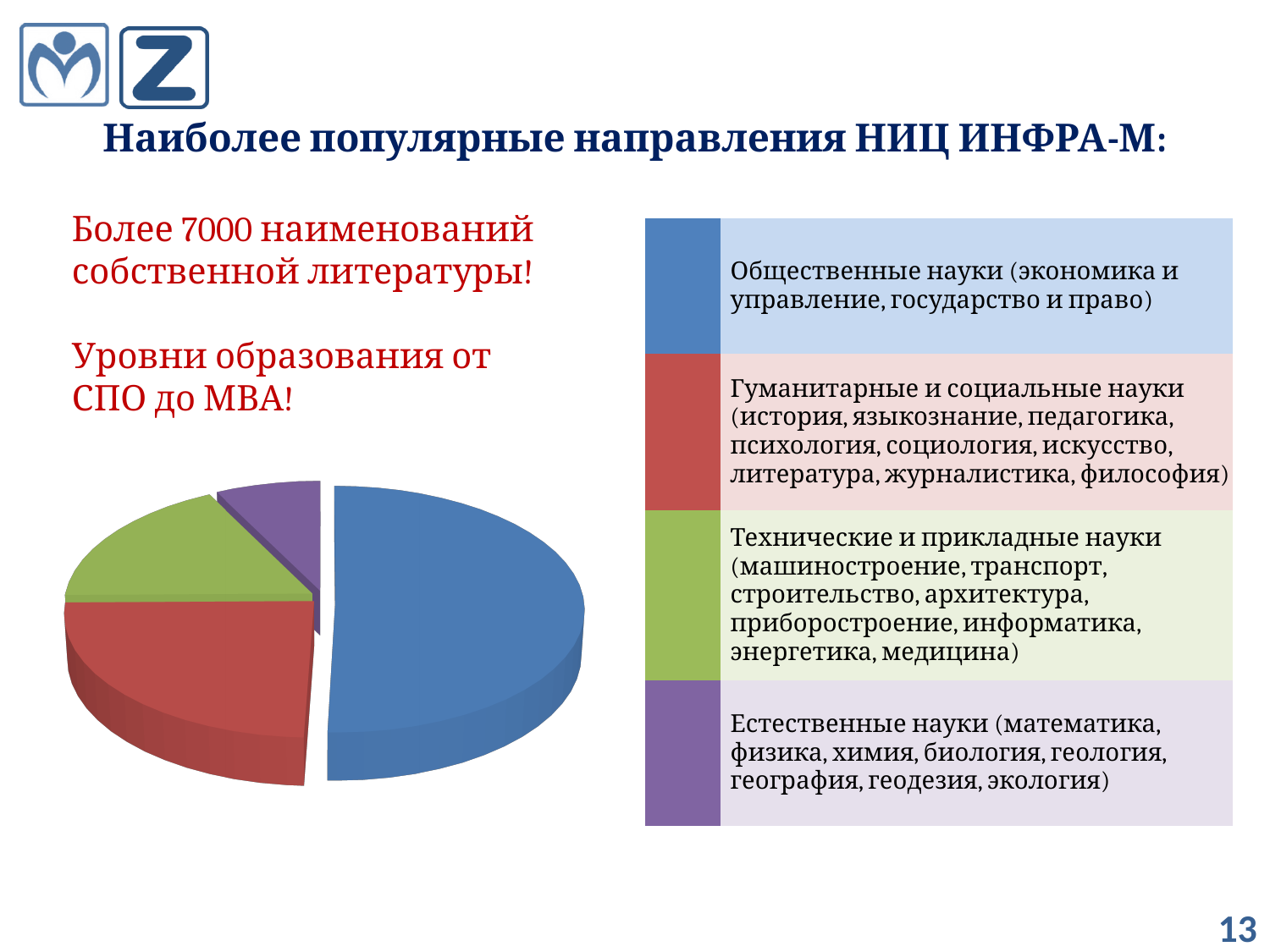
Which slice is larger: Гуманитарные и социальные науки or Технические и прикладные науки? Гуманитарные и социальные науки Which colour represents Технические и прикладные науки in the pie chart? Green Which slice is larger: Гуманитарные и социальные науки or Естественные науки? Гуманитарные и социальные науки Which slice is larger: Общественные науки or Технические и прикладные науки? Общественные науки How many slices does the pie chart have? 4 Which category has the largest slice of the pie chart? Общественные науки (экономика и управление, государство и право) Which category has the smallest slice of the pie chart? Естественные науки (математика, физика, химия, биология, геология, география, геодезия, экология) What kind of chart is shown on the slide? Pie chart What is the title of the slide containing the pie chart? Наиболее популярные направления НИЦ ИНФРА-М: